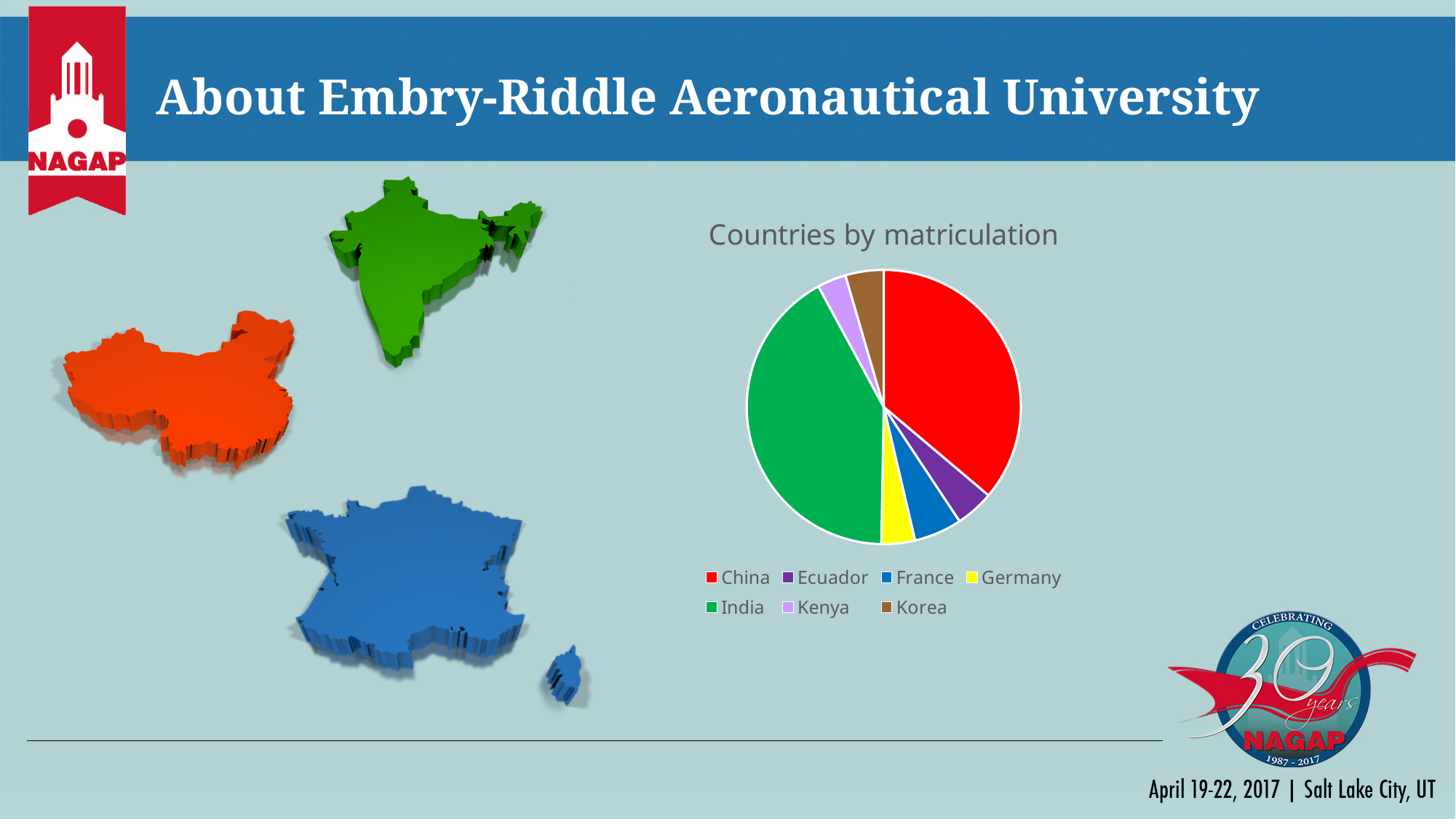
Which slice is larger, China or Ecuador? China What colour represents India in the pie chart? green Which slice is larger, Ecuador or India? India Which slice is larger, Korea or Kenya? Korea What kind of chart is shown on the slide? pie chart What is the title of the chart? Countries by matriculation How many countries are shown in the pie chart? 7 Which country has the smallest slice in the pie chart? Kenya